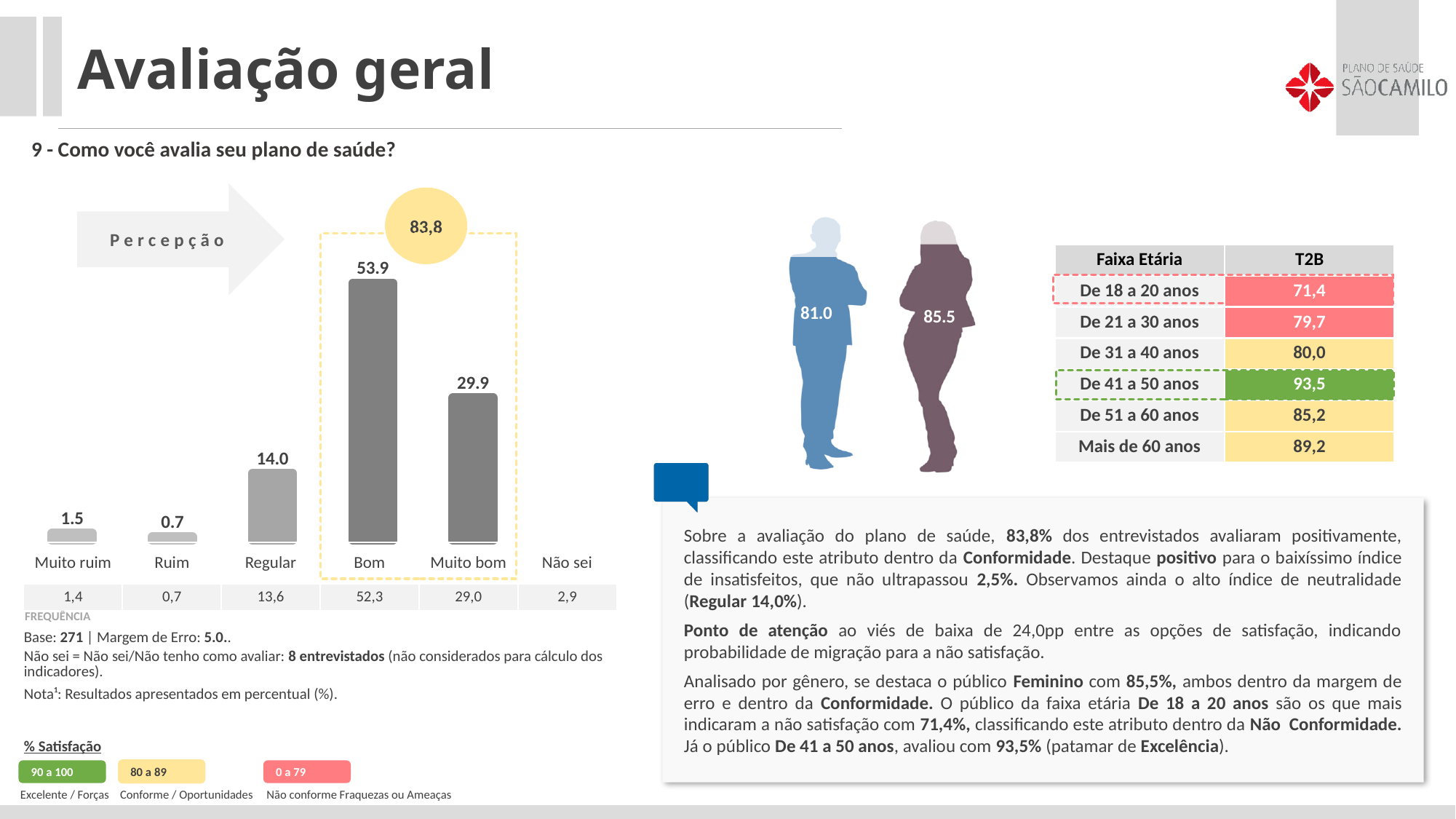
Which category has the highest bar in the chart? Bom What is the value shown for Muito ruim in the bar chart? 1.5 What is the value shown for Regular in the bar chart? 14.0 Which category has the lowest labelled bar in the chart? Ruim What is the difference between the values for Bom and Muito bom? 24.0 What kind of chart is used to show the answers to question 9? Bar chart What is the value shown for Bom in the bar chart? 53.9 What value is printed in the yellow circle above the highlighted bars? 83,8 Which is larger, the value for Regular or the value for Muito bom? Muito bom What is the value shown for Ruim in the bar chart? 0.7 What is the combined value of Bom and Muito bom in the bar chart? 83.8 How many categories are labelled along the x axis of the bar chart? 6